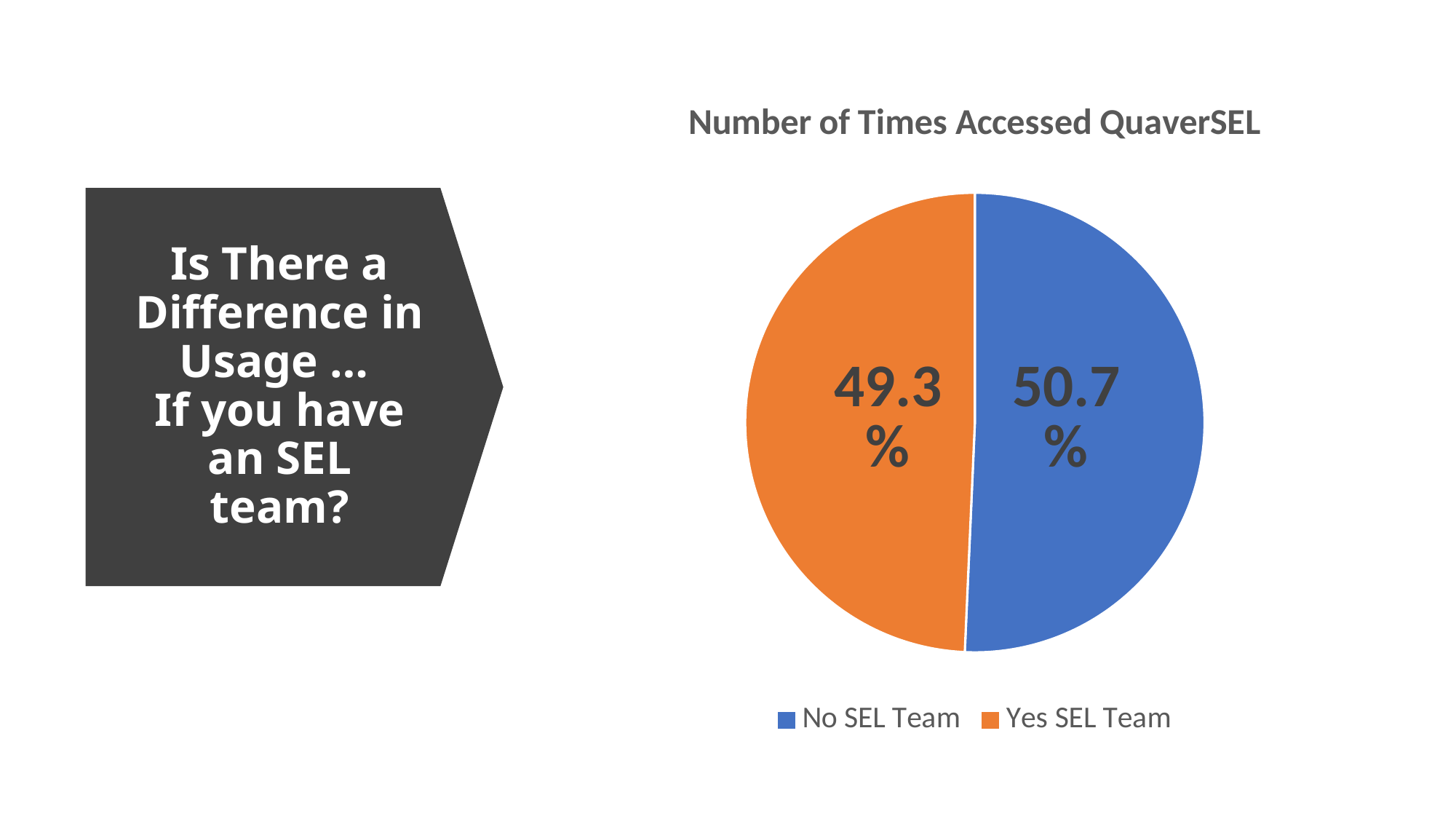
How many slices does the pie chart have? 2 What is the title of the chart? Number of Times Accessed QuaverSEL Which category has the smallest share of the pie? Yes SEL Team Which slice has the larger share, No SEL Team or Yes SEL Team? No SEL Team What is the difference in percentage points between the No SEL Team and Yes SEL Team slices? 1.4 What kind of chart is shown on the slide? pie chart Which category has the largest share of the pie? No SEL Team What share of the pie is labelled for Yes SEL Team? 49.3% What share of the pie is labelled for No SEL Team? 50.7% Which colour represents Yes SEL Team in the pie chart? orange How many entries does the legend list? 2